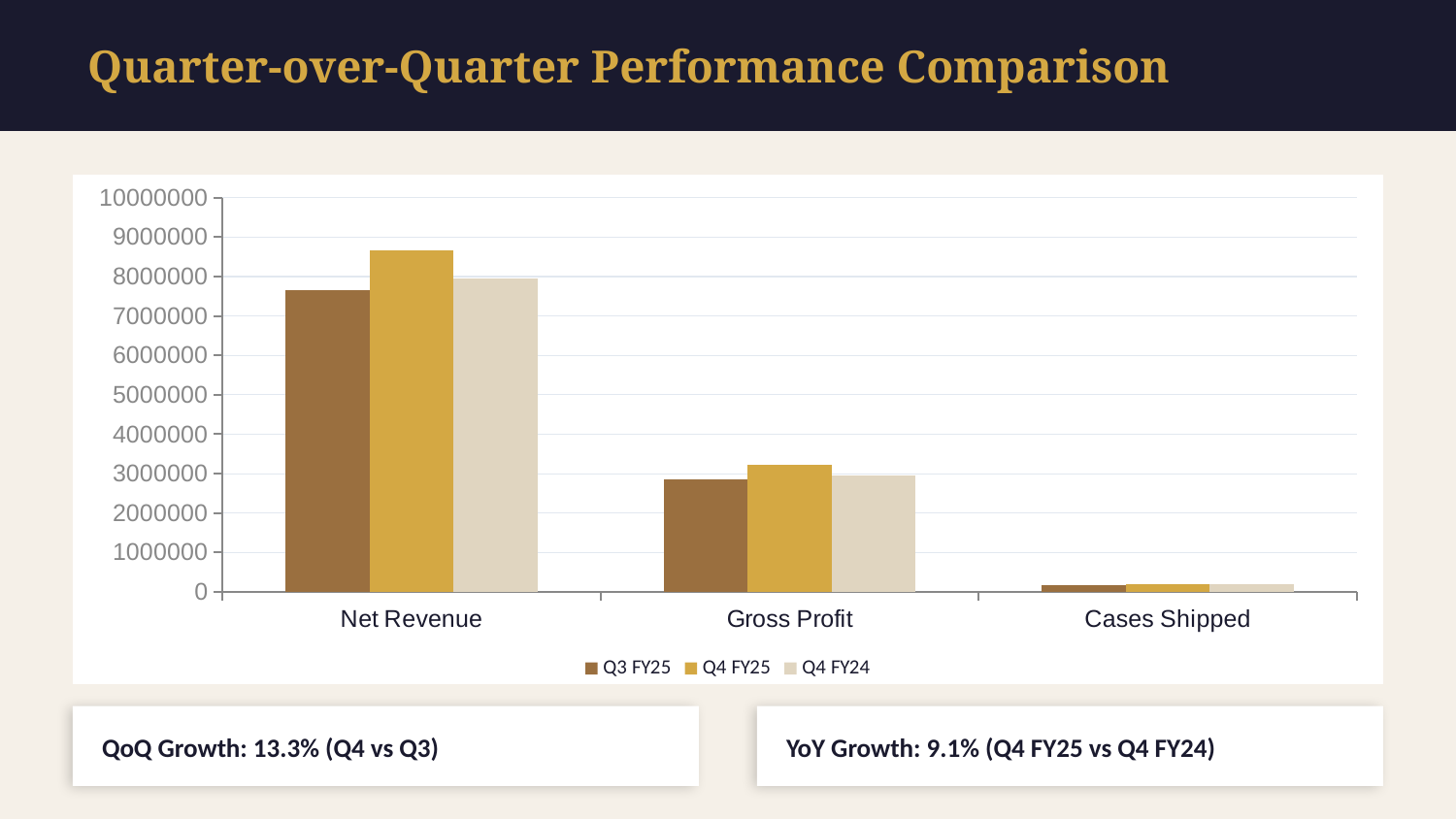
What kind of chart is shown on the slide? Bar chart What is the title of the slide containing the chart? Quarter-over-Quarter Performance Comparison Is the Gross Profit value for Q3 FY25 greater or less than 3000000? less How many series does the legend list? 3 Is the Net Revenue value for Q4 FY25 greater or less than 8000000? greater For Net Revenue, which is larger: Q4 FY24 or Q3 FY25? Q4 FY24 Which category has the lowest values across all series? Cases Shipped Is the Gross Profit value for Q4 FY25 greater or less than 3000000? greater Which series has the lowest Net Revenue? Q3 FY25 How many categories are shown on the x axis? 3 Which series has the highest Net Revenue? Q4 FY25